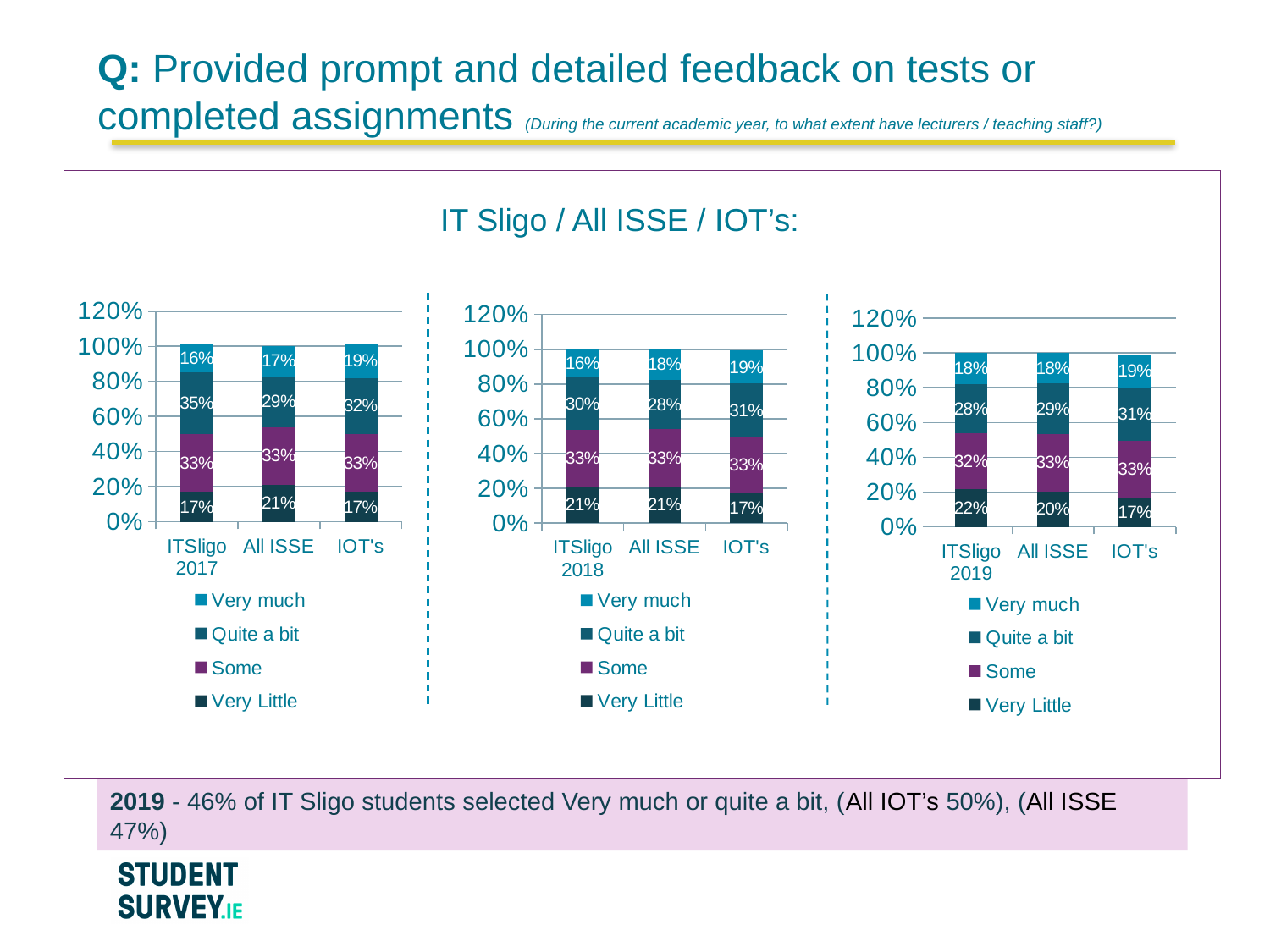
In the left chart (2017), what is the Very Little value for All ISSE? 21% What kind of chart is the left chart (2017)? Stacked bar chart In the middle chart (2018), what is the Very much value for IOT's? 19% In the right chart (2019), what is the Quite a bit value for IOT's? 31% In the right chart (2019), which category has the lowest Very Little value? IOT's In the middle chart (2018), which is larger: the Quite a bit value for ITSligo 2018 or for All ISSE? ITSligo 2018 In the left chart (2017), what is the difference between the Quite a bit values for ITSligo 2017 and All ISSE? 6% How many categories are shown on the x axis of the middle chart (2018)? 3 In the right chart (2019), what percentage of ITSligo 2019 respondents selected Very Little? 22% How many series does the legend of the right chart (2019) list? 4 In the left chart (2017), what percentage of ITSligo 2017 respondents selected Quite a bit? 35% In the left chart (2017), which category has the highest Quite a bit value? ITSligo 2017